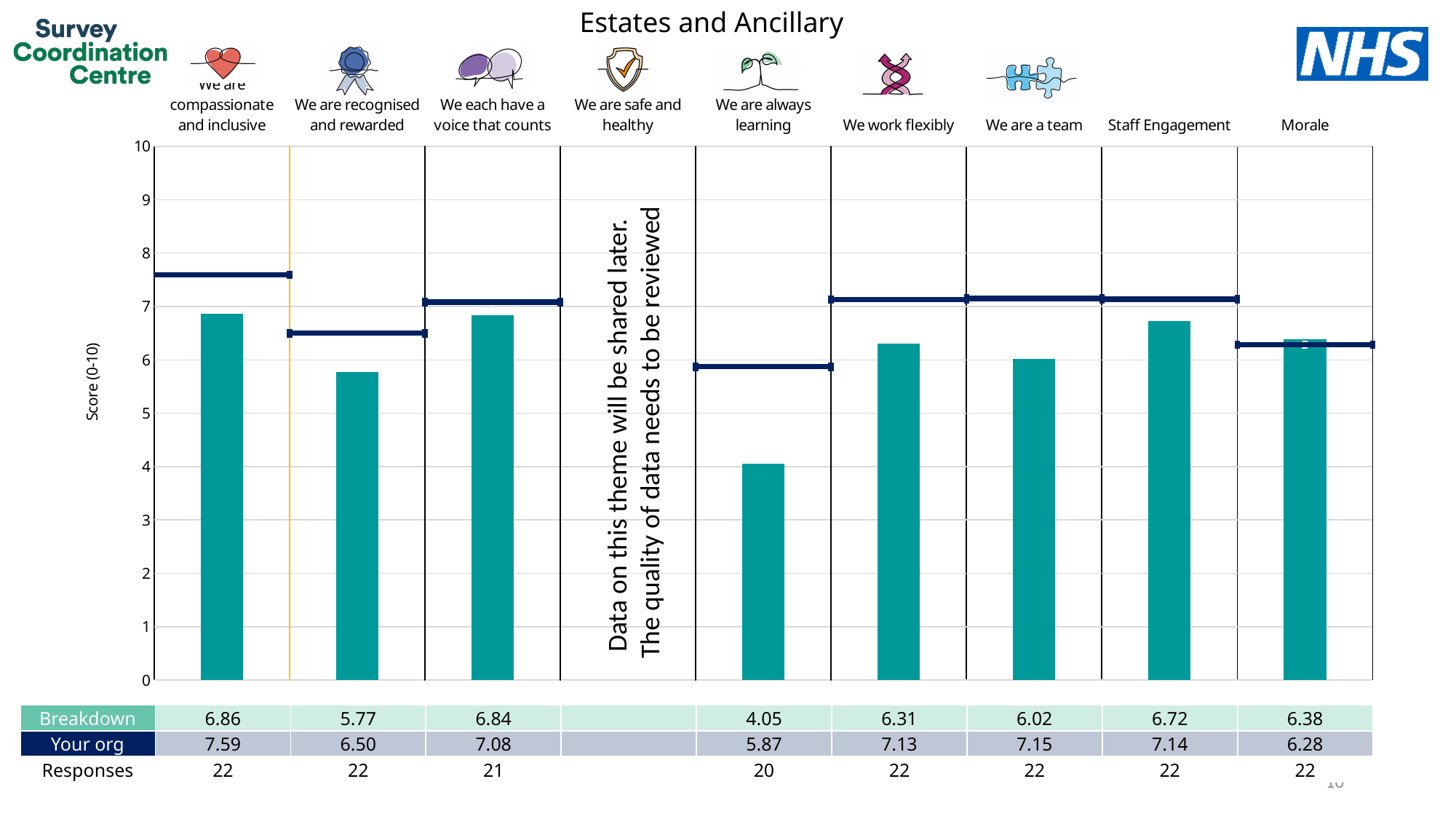
For 'Morale', which is larger: the Breakdown score or the 'Your org' score? Breakdown Is the Breakdown score for 'We are recognised and rewarded' greater or less than 6? less Which theme has the lowest Breakdown score? We are always learning Which theme has the highest 'Your org' score? We are compassionate and inclusive How many themes have a Breakdown bar plotted on the chart? 8 What kind of chart is shown on the slide? Bar chart What is the title of the chart? Estates and Ancillary What is the 'Your org' score for 'We are compassionate and inclusive'? 7.59 What is the Breakdown score for 'We are always learning'? 4.05 Why is there no bar for 'We are safe and healthy'? Data on this theme will be shared later; the quality of data needs to be reviewed How many responses were recorded for 'We each have a voice that counts'? 21 What is the difference between the 'Your org' score and the Breakdown score for 'We are always learning'? 1.82